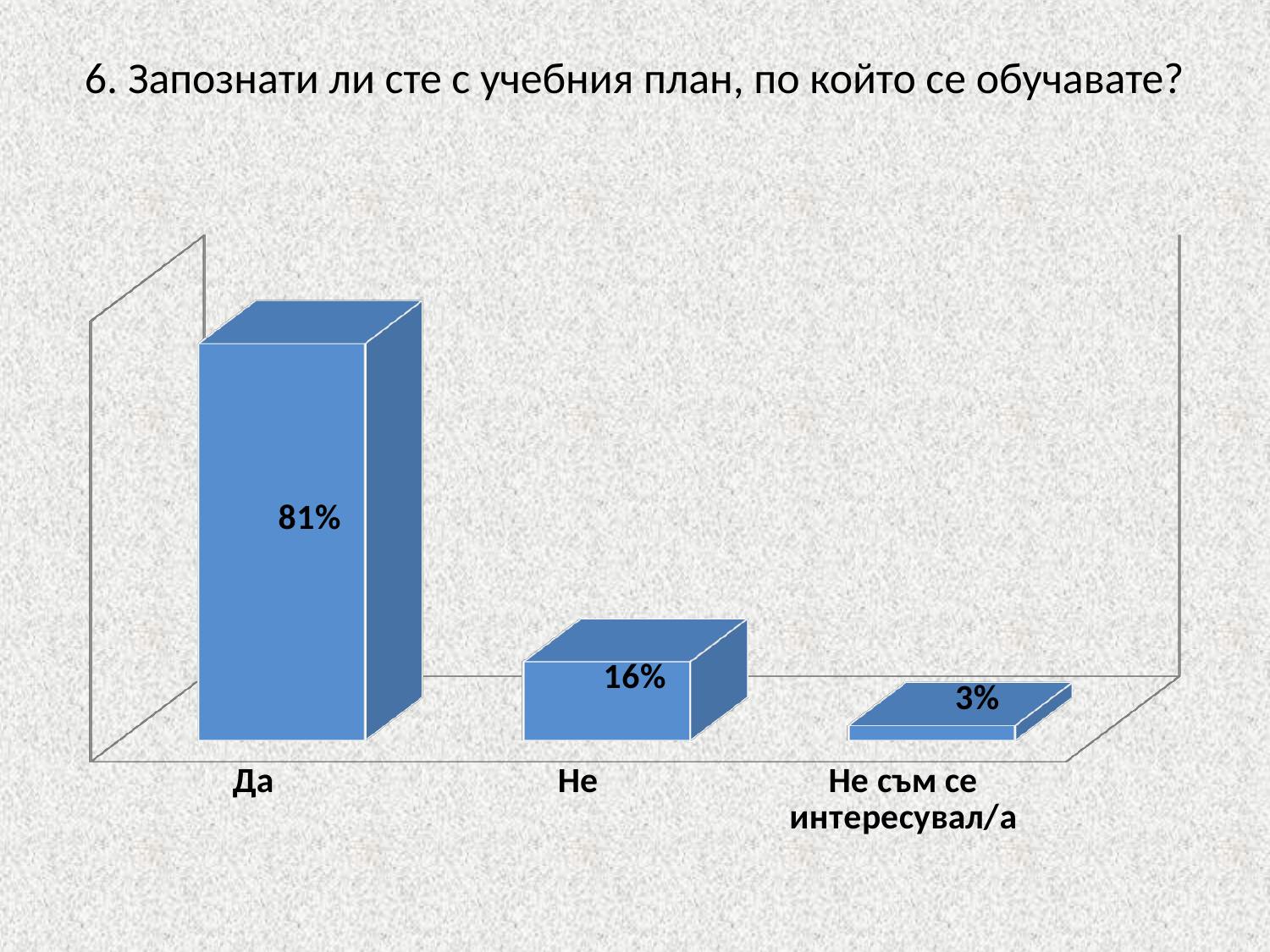
Which category has the lowest value? Не съм се интересувал/а What is the difference between the values for "Да" and "Не"? 65% How many categories are shown in the chart? 3 What is the title of the slide above the chart? 6. Запознати ли сте с учебния план, по който се обучавате? Which is larger, the value for "Не" or the value for "Не съм се интересувал/а"? Не Do the values rise or fall from left to right across the categories? fall What kind of chart is shown on the slide? bar chart What is the difference between the values for "Не" and "Не съм се интересувал/а"? 13% Which category has the highest value? Да What is the value for "Не"? 16% What is the value for "Не съм се интересувал/а"? 3% What is the value for "Да"? 81%